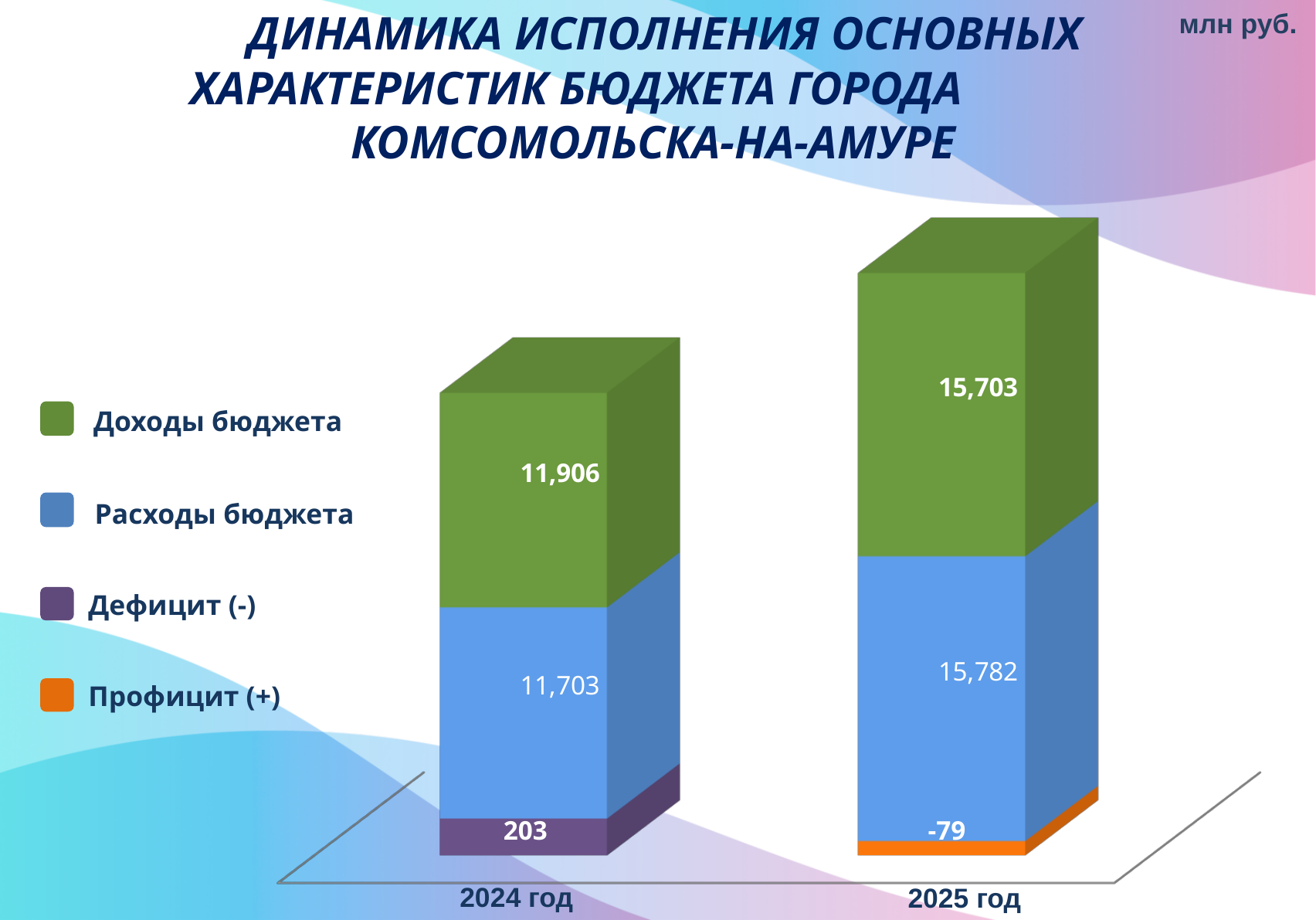
What value is printed on the bottom segment of the 2025 год bar? -79 What is the difference between Расходы бюджета and Доходы бюджета in 2025 год? 79 How many series does the legend list? 4 What kind of chart is shown on the slide? Stacked bar chart What value is printed on the bottom segment of the 2024 год bar? 203 In 2025 год, which is larger: Доходы бюджета or Расходы бюджета? Расходы бюджета How many years (categories) are shown on the x axis? 2 What is the value of Расходы бюджета for 2025 год? 15,782 What is the difference between Доходы бюджета in 2025 год and in 2024 год? 3,797 In what units are the values on the chart given, according to the slide? млн руб. What is the value of Доходы бюджета for 2024 год? 11,906 Which year has the higher value for Доходы бюджета? 2025 год